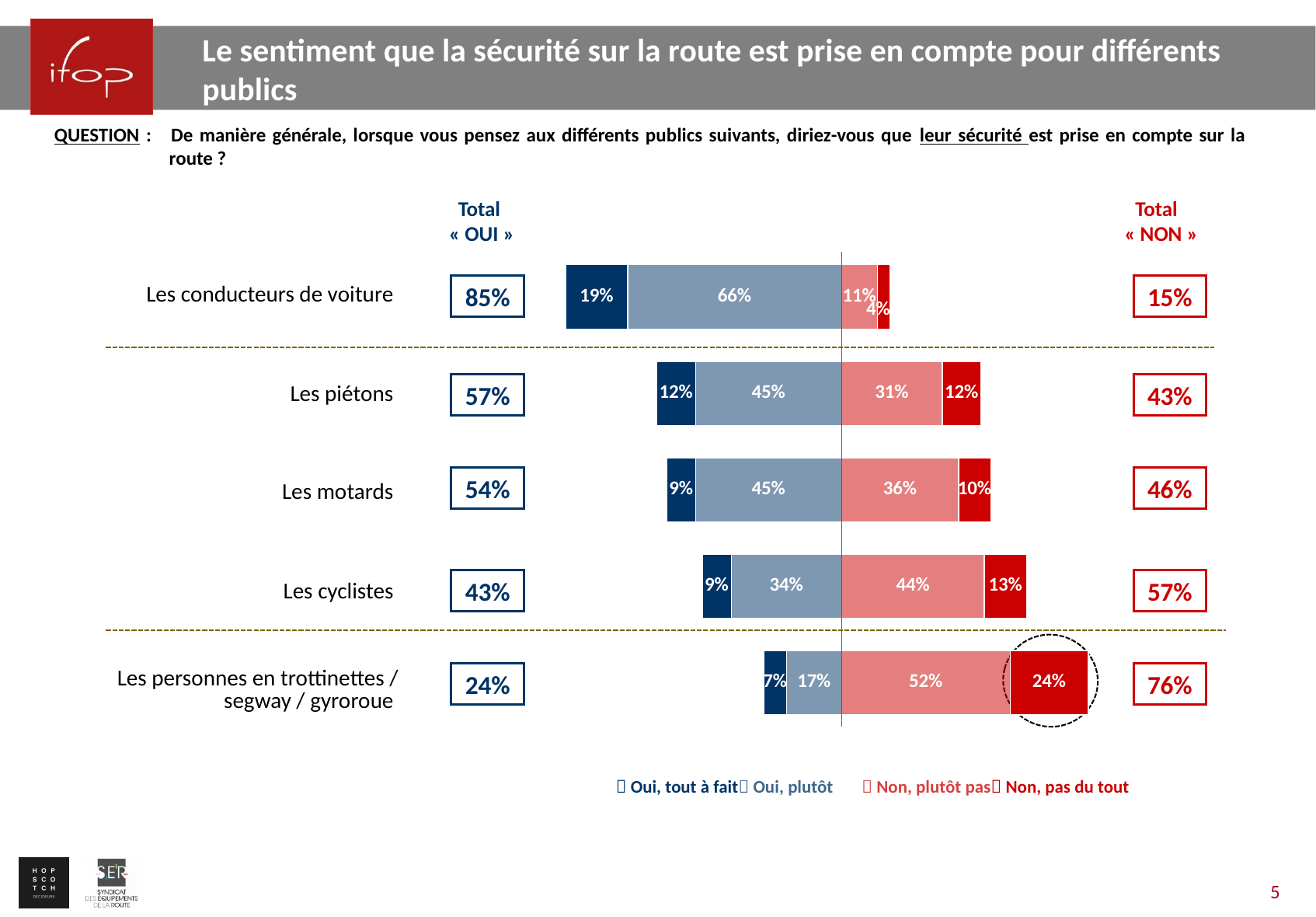
How many series does the legend list? 4 What is the Total « OUI » value for Les motards? 54% What is the "Oui, plutôt" value for Les conducteurs de voiture? 66% What is the difference between the Total « OUI » values for Les conducteurs de voiture and Les piétons? 28% What is the "Non, pas du tout" value for Les personnes en trottinettes / segway / gyroroue? 24% Which category has the lowest "Oui, tout à fait" value? Les personnes en trottinettes / segway / gyroroue Which is larger: the "Non, plutôt pas" value for Les piétons or for Les motards? Les motards What is the total of the two "Oui" segments for Les cyclistes? 43% What is the "Non, plutôt pas" value for Les cyclistes? 44% How many categories (publics) are shown in the chart? 5 What kind of chart is shown on the slide? Stacked bar chart Which category has the highest Total « NON » value? Les personnes en trottinettes / segway / gyroroue